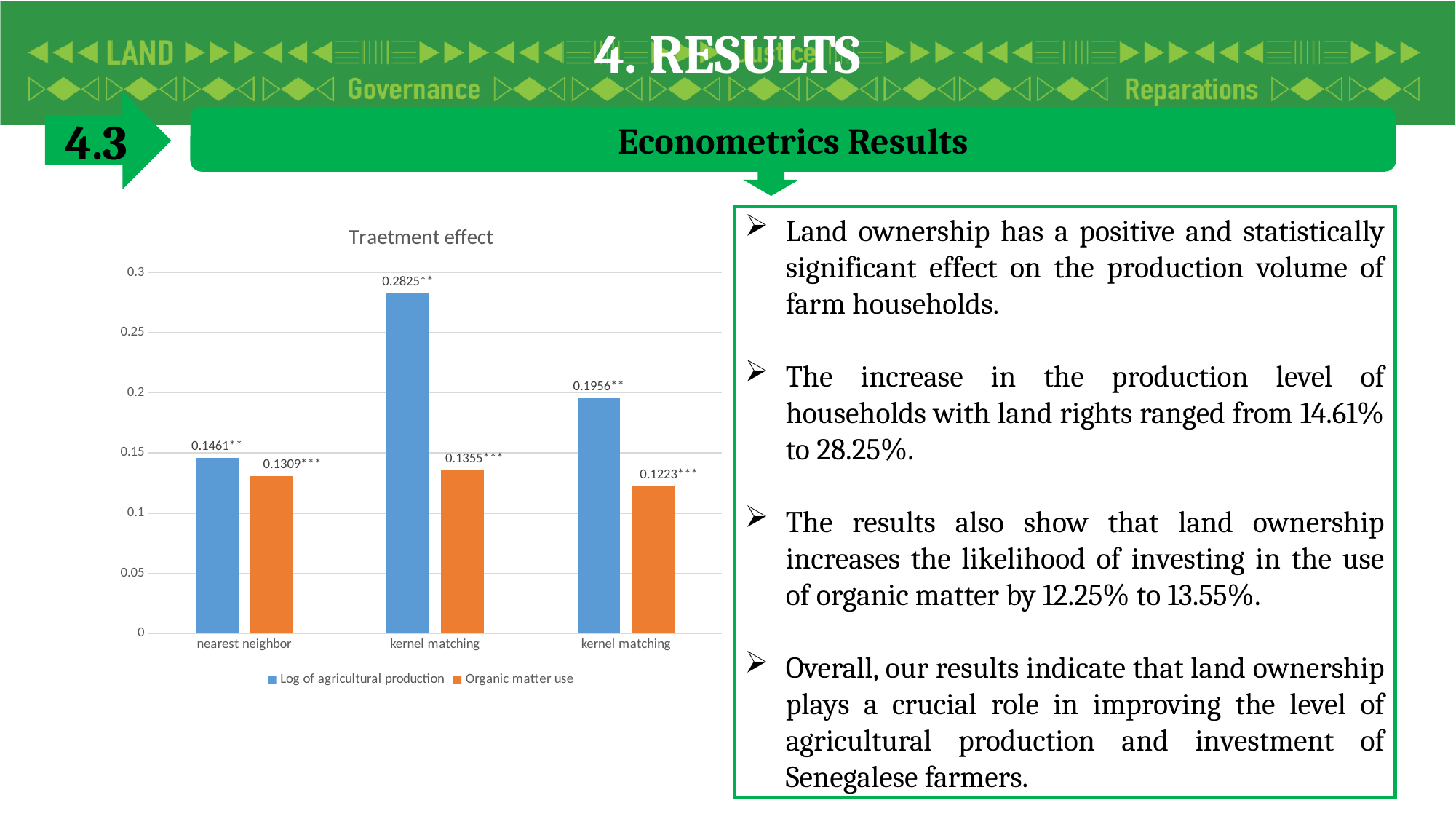
Is the Log of agricultural production value for the rightmost kernel matching category greater or less than 0.15? greater How many categories are shown on the x axis of the chart? 3 What is the value of Log of agricultural production for nearest neighbor? 0.1461** What is the value of Organic matter use for nearest neighbor? 0.1309*** Which category has the highest Log of agricultural production value? kernel matching (middle category) Which category has the lowest Organic matter use value? kernel matching (rightmost category) How many series does the chart legend list? 2 What is the value of Organic matter use for the rightmost category (second kernel matching)? 0.1223*** What type of chart is shown on the slide? bar chart What is the difference between the Log of agricultural production values for the middle kernel matching category and nearest neighbor? 0.1364 What is the value of Log of agricultural production for the middle category (first kernel matching)? 0.2825** What is the title of the chart? Traetment effect